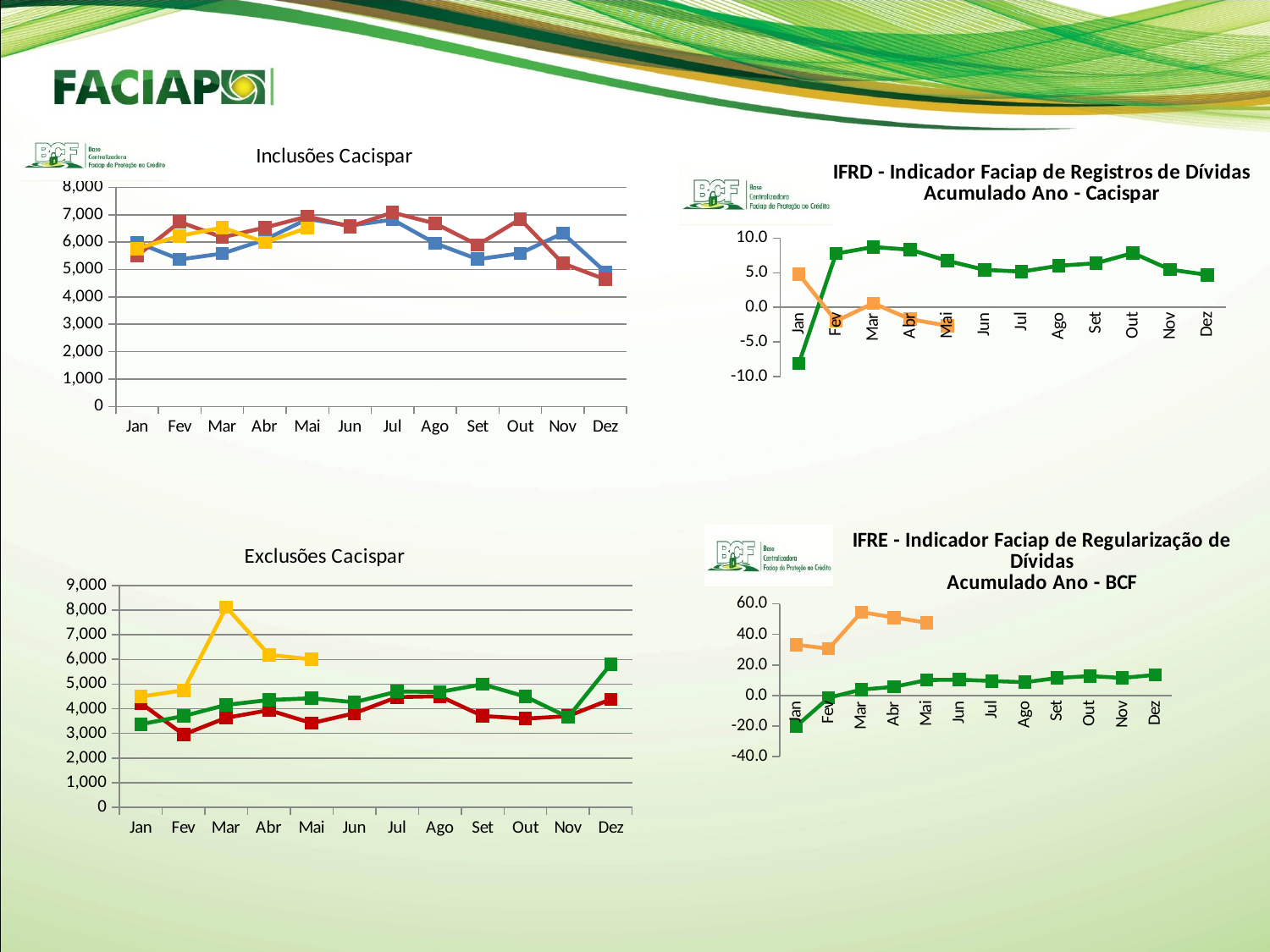
In the 'Inclusões Cacispar' chart, is the red series value for Jan greater or less than 6,000? less In the 'IFRD - Indicador Faciap de Registros de Dívidas Acumulado Ano - Cacispar' chart, is the green series value for Jan greater or less than -5.0? less In the 'Exclusões Cacispar' chart, which month has the highest value for the yellow series? Mar In the 'Exclusões Cacispar' chart, which month has the lowest value for the red series? Fev What type of chart is the 'Inclusões Cacispar' chart? Line chart In the 'IFRE - Indicador Faciap de Regularização de Dívidas Acumulado Ano - BCF' chart, which month has the highest value for the orange series? Mar In the 'Inclusões Cacispar' chart, is the red series value for Dez greater or less than 5,000? less How many months are shown on the x axis of the 'Inclusões Cacispar' chart? 12 In the 'IFRD - Indicador Faciap de Registros de Dívidas Acumulado Ano - Cacispar' chart, which month has the lowest value for the green series? Jan